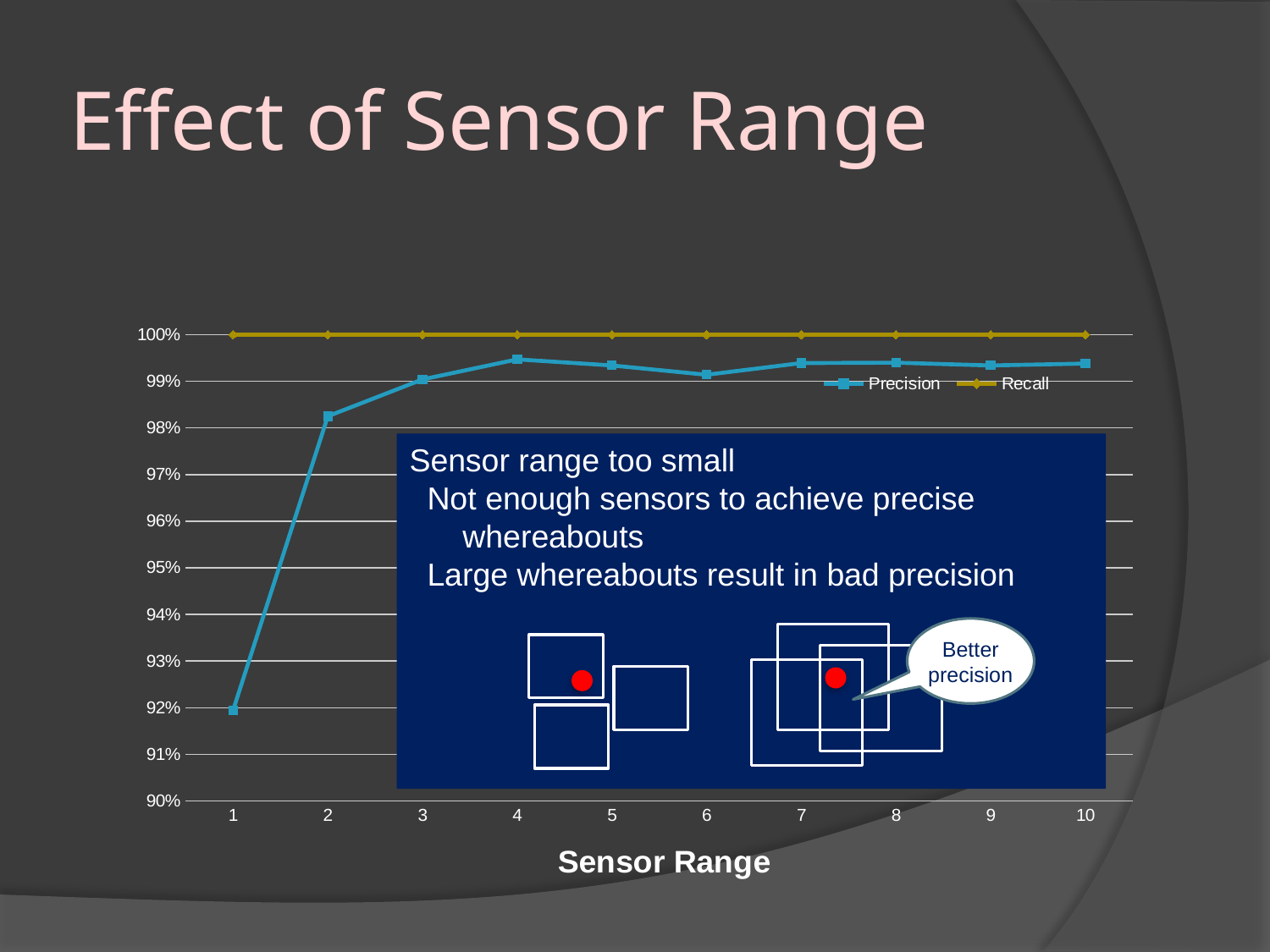
What are the two series named in the legend? Precision and Recall Does Precision rise or fall as sensor range increases from 1 to 4? rise How many sensor range values are plotted along the x axis? 10 What is the title of the x axis? Sensor Range At sensor range 1, which series has the larger value, Precision or Recall? Recall How many series does the chart legend list? 2 What is the Recall value at sensor range 5? 100% At which sensor range is Precision lowest? 1 Is the Precision value at sensor range 1 greater or less than 95%? less Is the Precision value at sensor range 2 greater or less than 97%? greater What kind of chart is shown on the slide? line chart Is the Precision value at sensor range 4 greater or less than 99%? greater